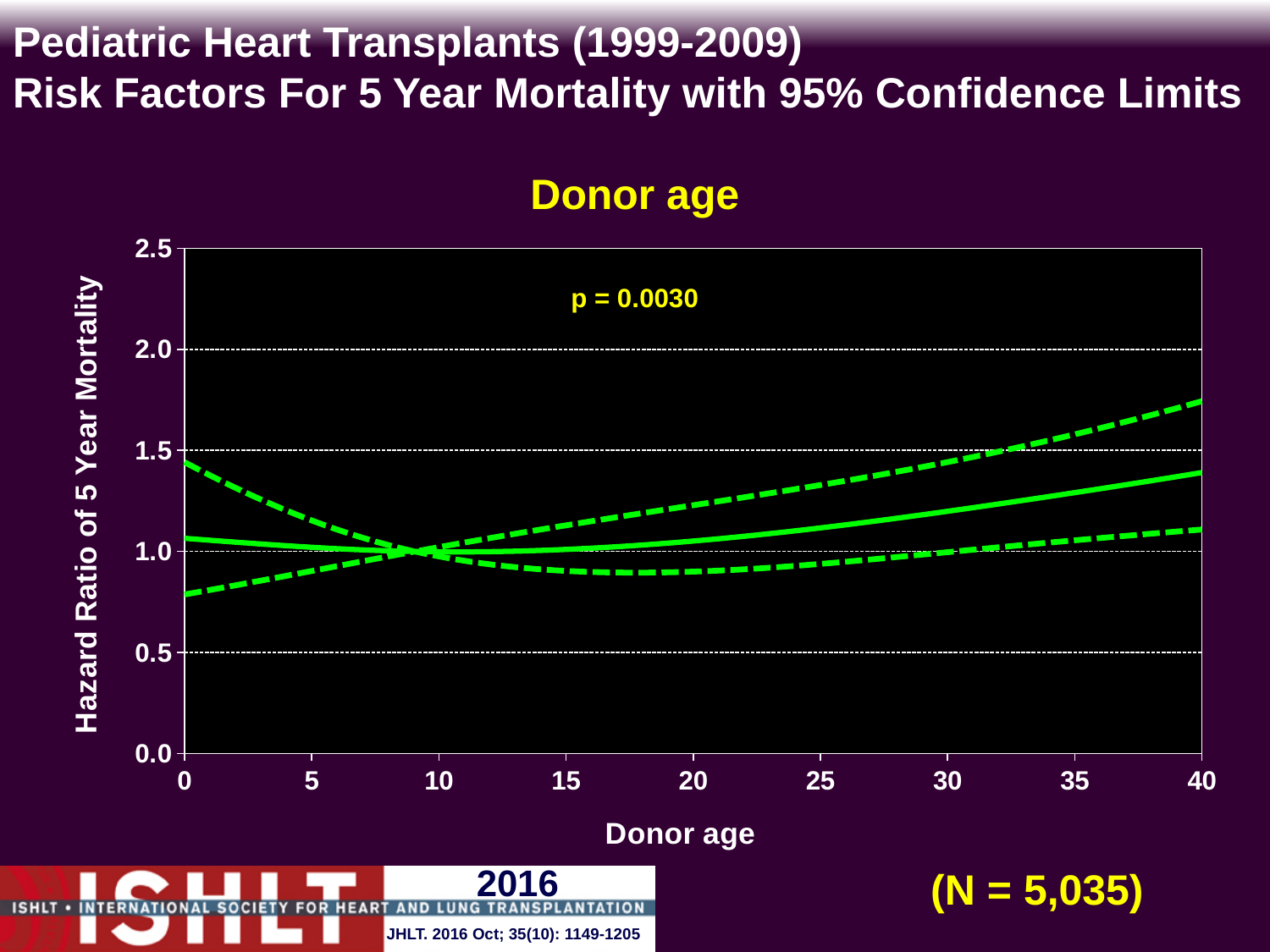
What is the p-value printed on the chart? p = 0.0030 Is the value of the solid hazard ratio line at donor age 40 greater or less than 1.0? greater Is the solid hazard ratio line higher at donor age 40 or at donor age 10? donor age 40 Is the value of the lower dashed confidence limit at donor age 0 greater or less than 1.0? less How many lines are plotted on the chart? 3 Does the solid hazard ratio line rise or fall overall as donor age increases from 0 to 40? rises Is the value of the solid hazard ratio line at donor age 40 greater or less than 1.5? less What is the title of the chart? Donor age What is the highest value shown on the y axis? 2.5 What kind of chart is shown on the slide? line chart